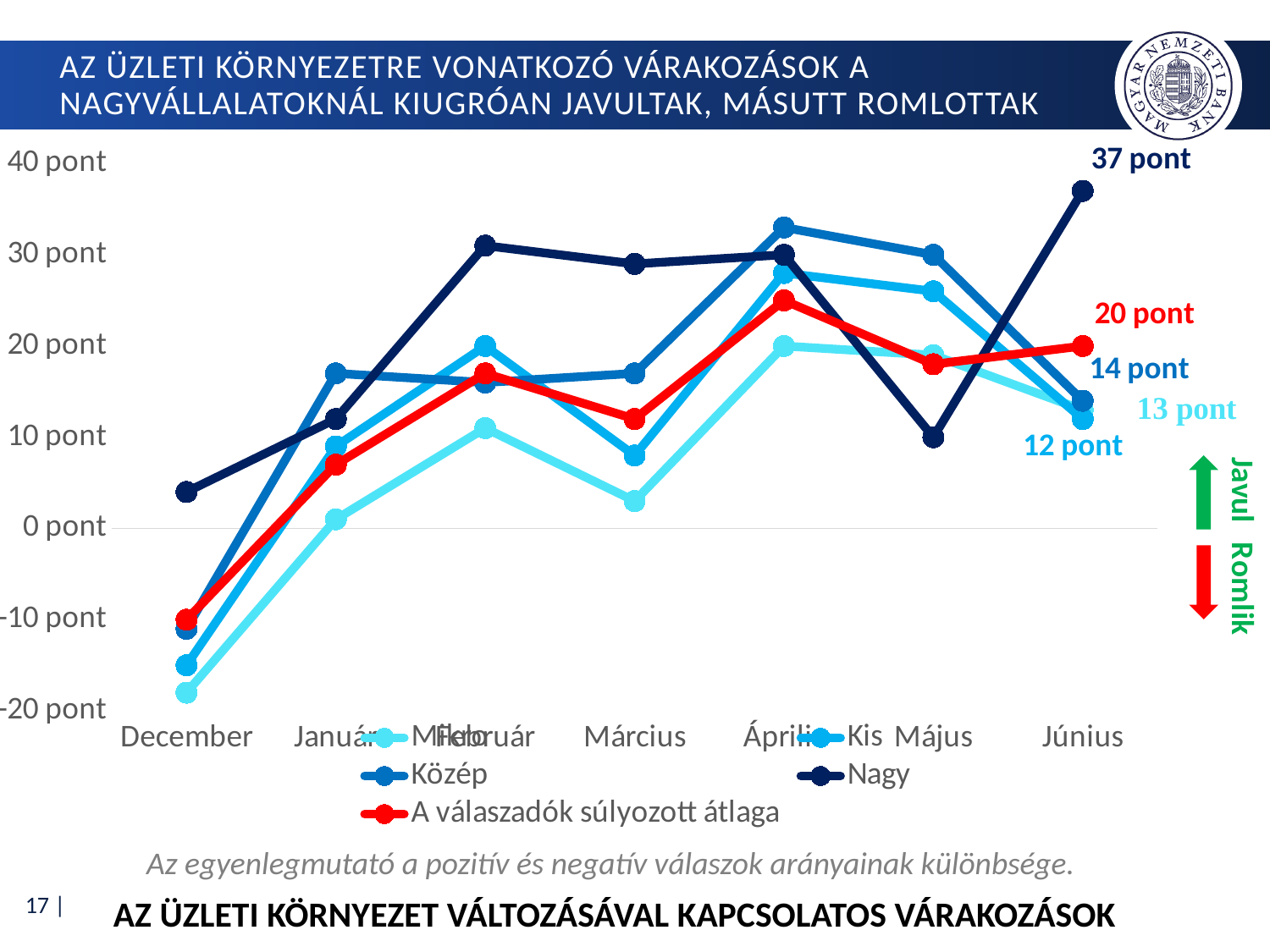
In Június, which is larger: the value for Közép or the value for Mikro? Közép Is the value for Mikro in December greater or less than -10 pont? less What is the value for Kis in Június? 12 pont Is the value for Közép in Április greater or less than 30 pont? greater How many series does the legend list? 5 What is the difference between the Nagy and Kis values in Június? 25 pont Which series has the lowest value in Június? Kis Which series has the highest value in Június? Nagy What kind of chart is shown on the slide? line chart What is the value for Nagy in Június? 37 pont What is the value for A válaszadók súlyozott átlaga in Június? 20 pont How many months are shown on the x axis? 7